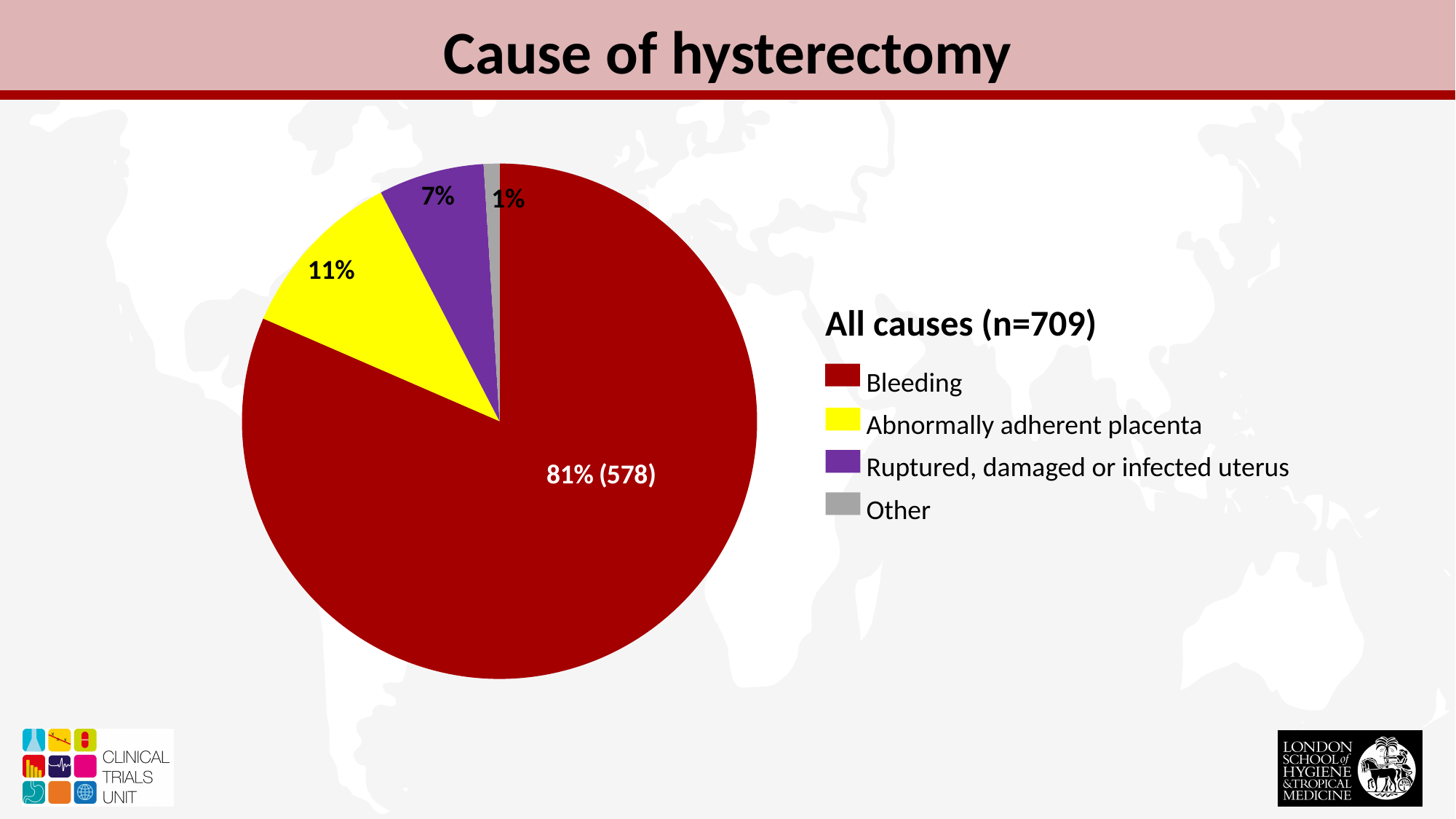
What share of the pie does Bleeding account for? 81% How many slices does the pie chart have? 4 What is the difference in percentage points between Abnormally adherent placenta and Ruptured, damaged or infected uterus? 4 What kind of chart is shown on the slide? Pie chart Which cause has the largest slice of the pie? Bleeding What share of the pie does Other account for? 1% How many cases are in the Bleeding slice? 578 Which cause has the smallest slice of the pie? Other What share of the pie does Ruptured, damaged or infected uterus account for? 7% What is the total number of cases (n) stated in the legend heading? 709 Which is larger: the share for Abnormally adherent placenta or the share for Ruptured, damaged or infected uterus? Abnormally adherent placenta